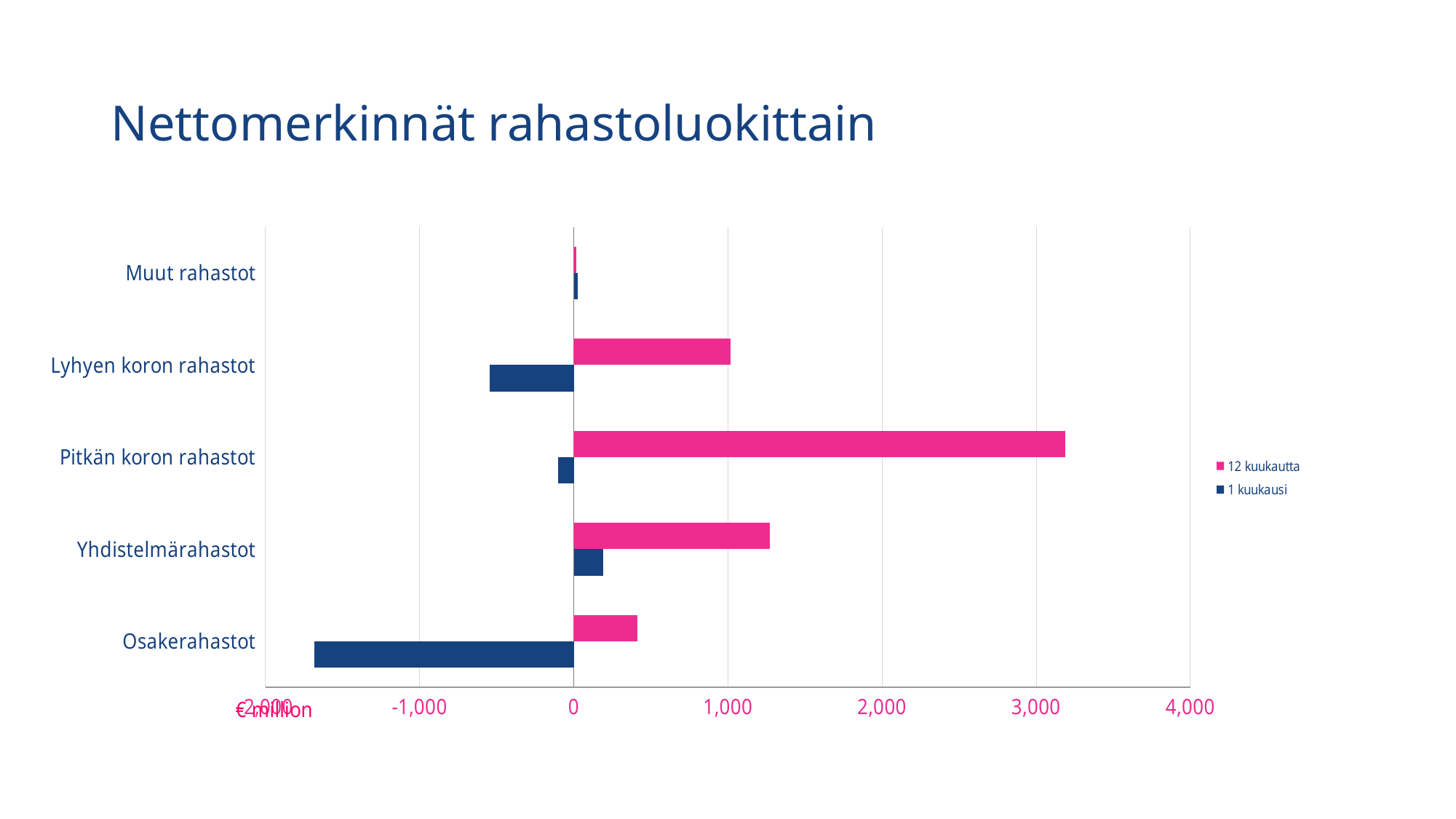
What is the title of the chart? Nettomerkinnät rahastoluokittain Which category has the highest value for the 1 kuukausi series? Yhdistelmärahastot How many series does the legend list? 2 How many fund categories are shown on the chart? 5 Is the 12 kuukautta value for Yhdistelmärahastot greater or less than 1,000? greater Which category has the lowest value for the 1 kuukausi series? Osakerahastot What kind of chart is shown on the slide? bar chart Is the 12 kuukautta value for Pitkän koron rahastot greater or less than 3,000? greater Which category has the highest value for the 12 kuukautta series? Pitkän koron rahastot For the 12 kuukautta series, which is larger: Pitkän koron rahastot or Yhdistelmärahastot? Pitkän koron rahastot Is the 12 kuukautta value for Osakerahastot greater or less than 1,000? less